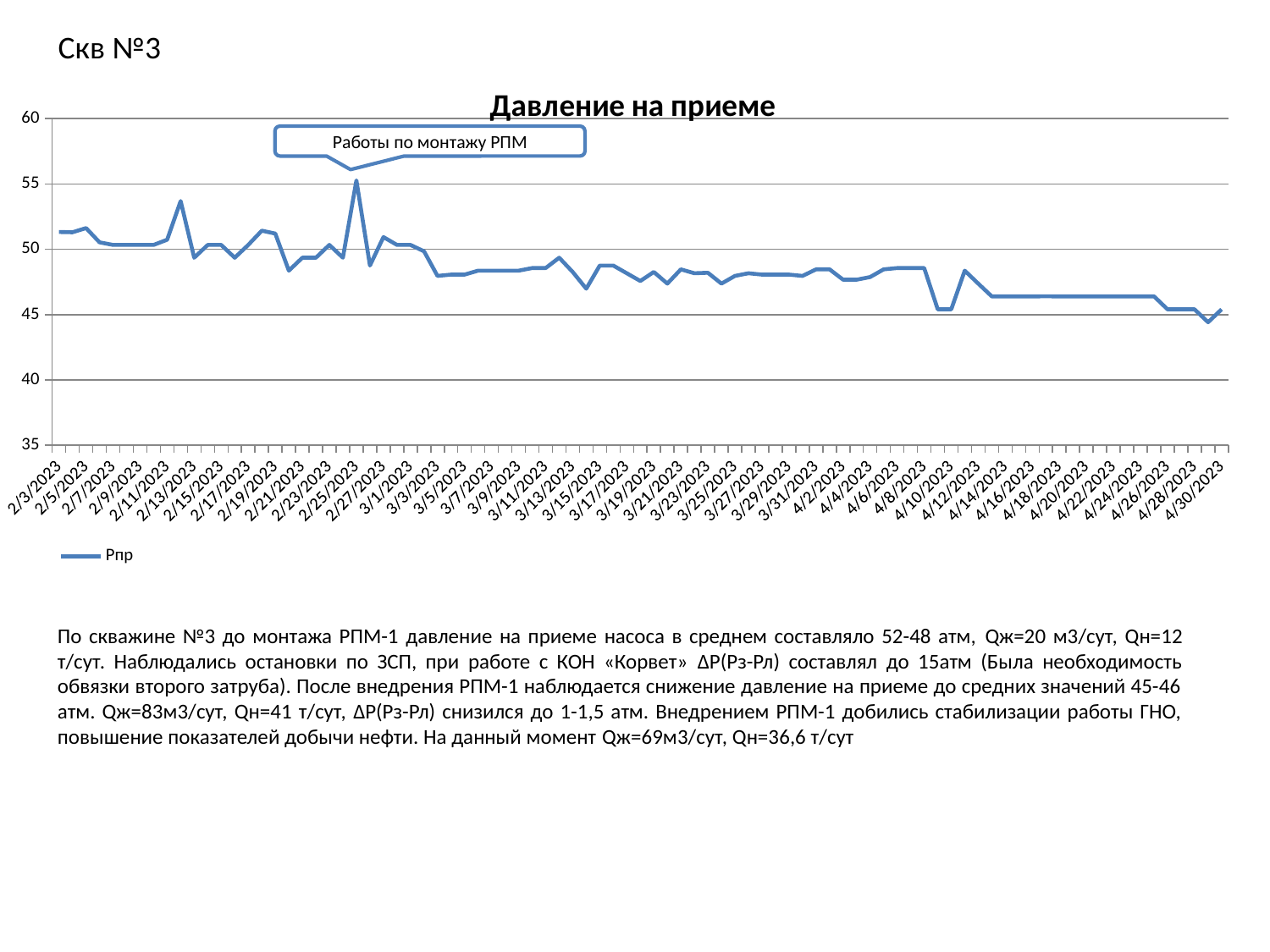
What is the title of the chart? Давление на приеме What kind of chart is shown on the slide? line chart Is the value for 4/10/2023 greater or less than 50? less Is the value for 2/13/2023 greater or less than 50? less Is the value for 3/15/2023 greater or less than 50? less How many series does the legend list? 1 In which month does the lowest value of the series occur? April What is the name of the series shown in the legend? Рпр On which date does the series reach its highest value? 2/25/2023 Overall, do the values of Рпр rise or fall from 2/3/2023 to 4/30/2023? fall